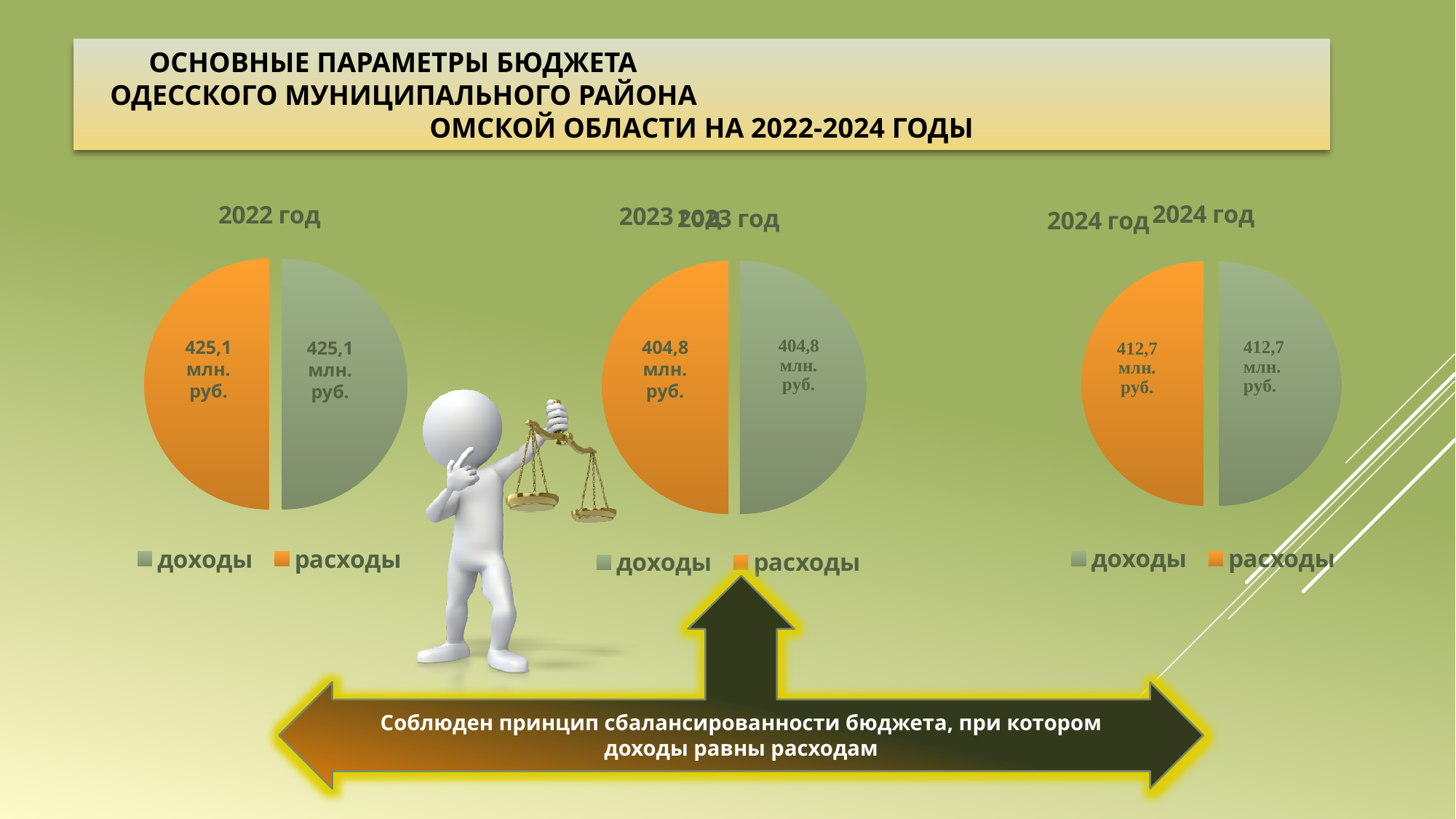
What kind of chart is the 2022 год chart? pie chart In the 2022 год chart, what is the difference between доходы and расходы? 0 How many pie charts are shown on the slide? 3 In the 2022 год chart, what is the value for доходы? 425,1 млн. руб. How many entries does the legend of the 2024 год chart list? 2 In the 2023 год chart, which is larger, доходы or расходы? They are equal In the 2022 год chart, which colour represents расходы? orange In the 2024 год chart, what is the value for доходы? 412,7 млн. руб. In the 2023 год chart, what is the value for расходы? 404,8 млн. руб. In the 2024 год chart, what share of the pie does the расходы slice represent? 50% How many slices does the 2023 год pie chart have? 2 In the 2022 год chart, what is the value for расходы? 425,1 млн. руб.